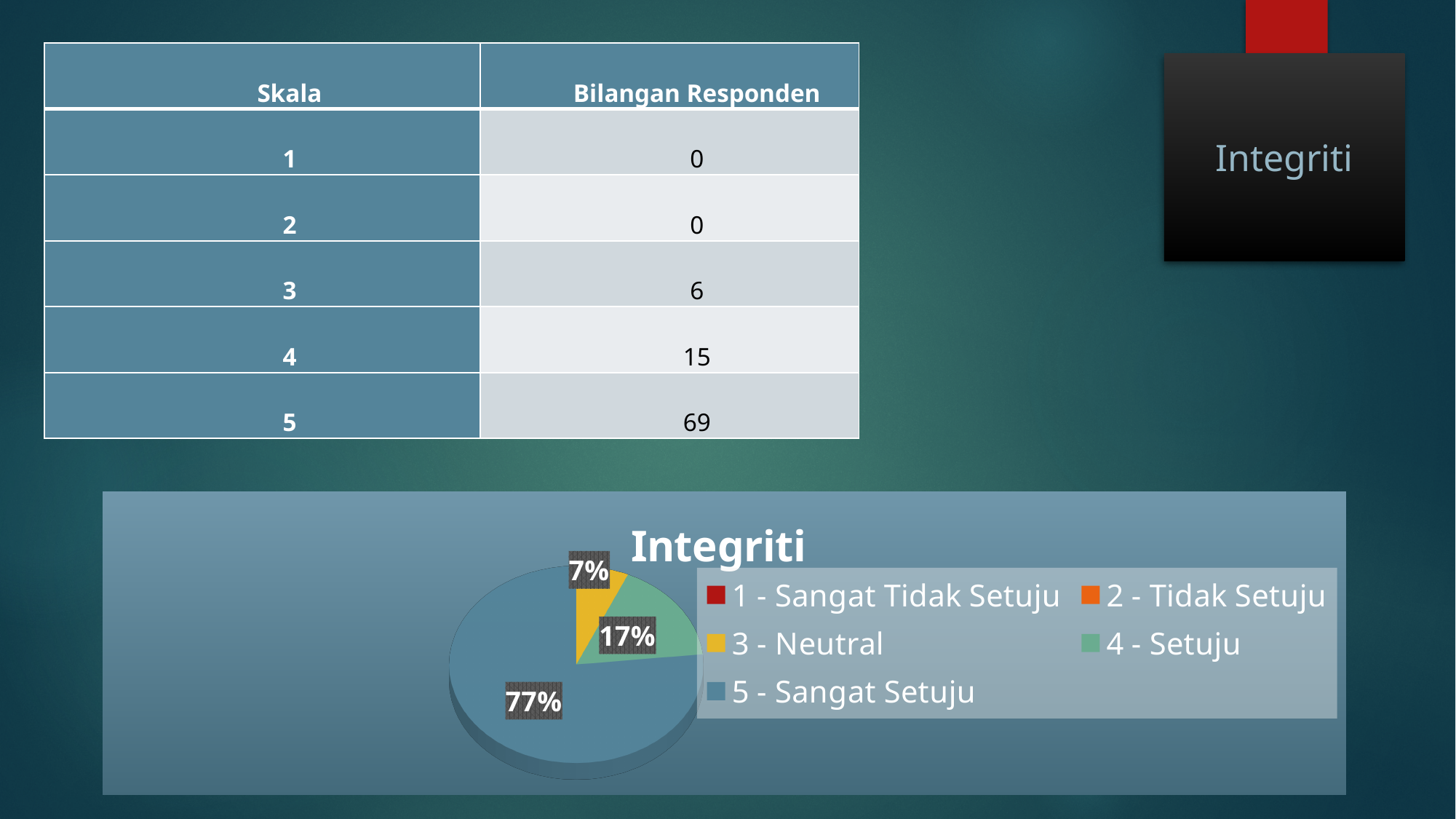
What share of the pie does 4 - Setuju have? 17% How many slices with percentage labels are visible in the pie chart? 3 What is the difference in percentage points between the 4 - Setuju slice and the 3 - Neutral slice? 10% What is the difference in percentage points between the 5 - Sangat Setuju slice and the 4 - Setuju slice? 60% What kind of chart is shown on the slide? pie chart What is the title of the pie chart? Integriti Which is larger in the pie chart, 4 - Setuju or 3 - Neutral? 4 - Setuju What share of the pie does 3 - Neutral have? 7% What share of the pie does 5 - Sangat Setuju have? 77% What colour is the 3 - Neutral slice in the pie chart? yellow How many entries does the legend of the pie chart list? 5 Which category has the largest slice of the pie? 5 - Sangat Setuju